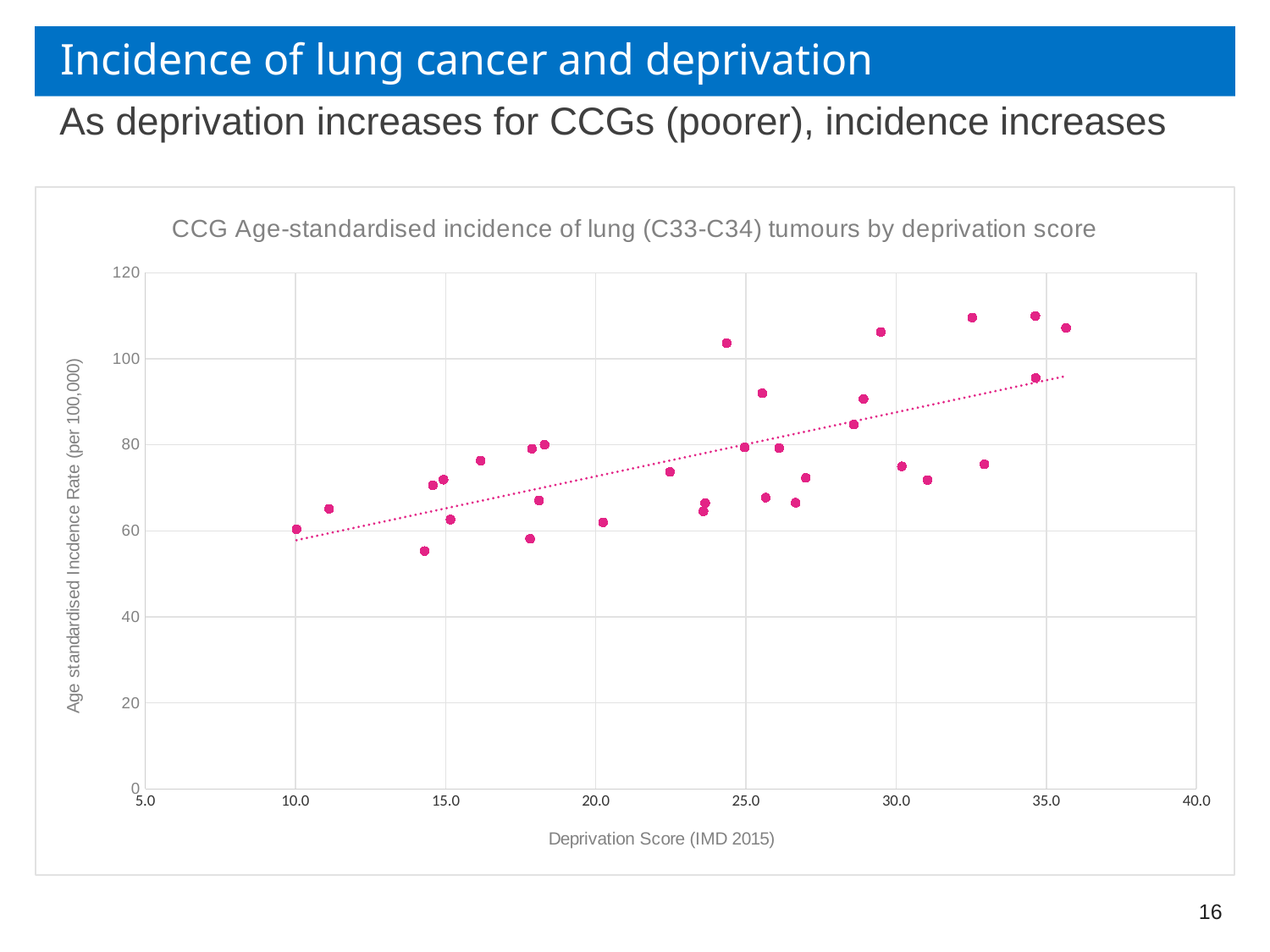
Is the incidence rate for the point with the lowest deprivation score (around 10.0) greater or less than 80? less What is the label of the x axis? Deprivation Score (IMD 2015) Is the lowest incidence rate plotted on the chart greater or less than 60? less Is the highest incidence rate plotted on the chart greater or less than 100? greater What is the title of the chart? CCG Age-standardised incidence of lung (C33-C34) tumours by deprivation score As deprivation score increases along the x axis, does the incidence rate generally rise or fall? Rise What kind of chart is shown on the slide? Scatter chart